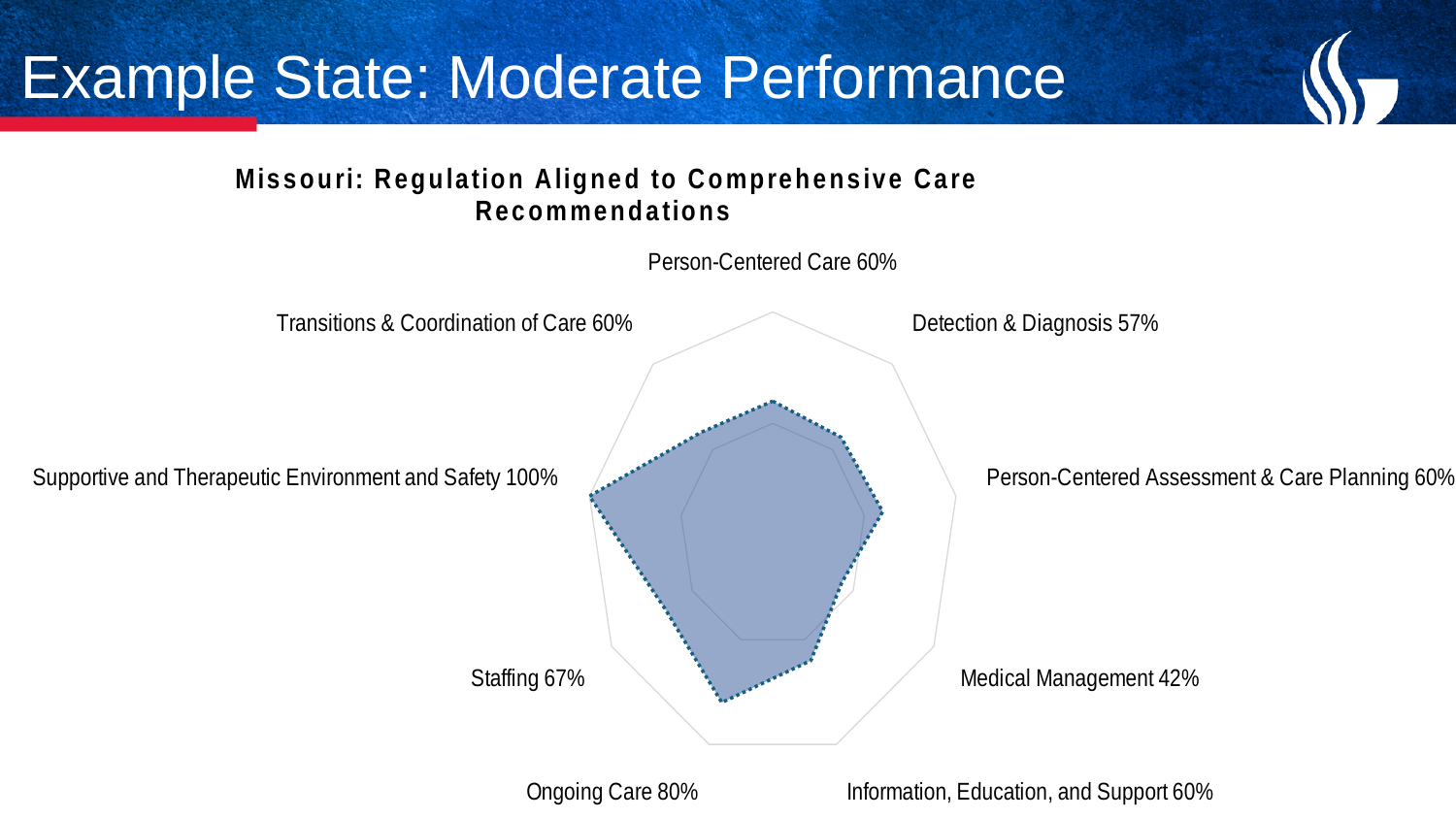
What is the difference between the values for Supportive and Therapeutic Environment and Safety and Medical Management? 58% Which category has the highest value? Supportive and Therapeutic Environment and Safety What kind of chart is shown on the slide? Radar chart What is the value for Ongoing Care? 80% Which category has the lowest value? Medical Management How many categories are plotted on the radar chart? 9 Which is larger, the value for Staffing or the value for Detection & Diagnosis? Staffing What is the value for Detection & Diagnosis? 57% What is the value for Supportive and Therapeutic Environment and Safety? 100% What is the title of the chart? Missouri: Regulation Aligned to Comprehensive Care Recommendations What is the value for Medical Management? 42% What is the difference between the values for Ongoing Care and Staffing? 13%